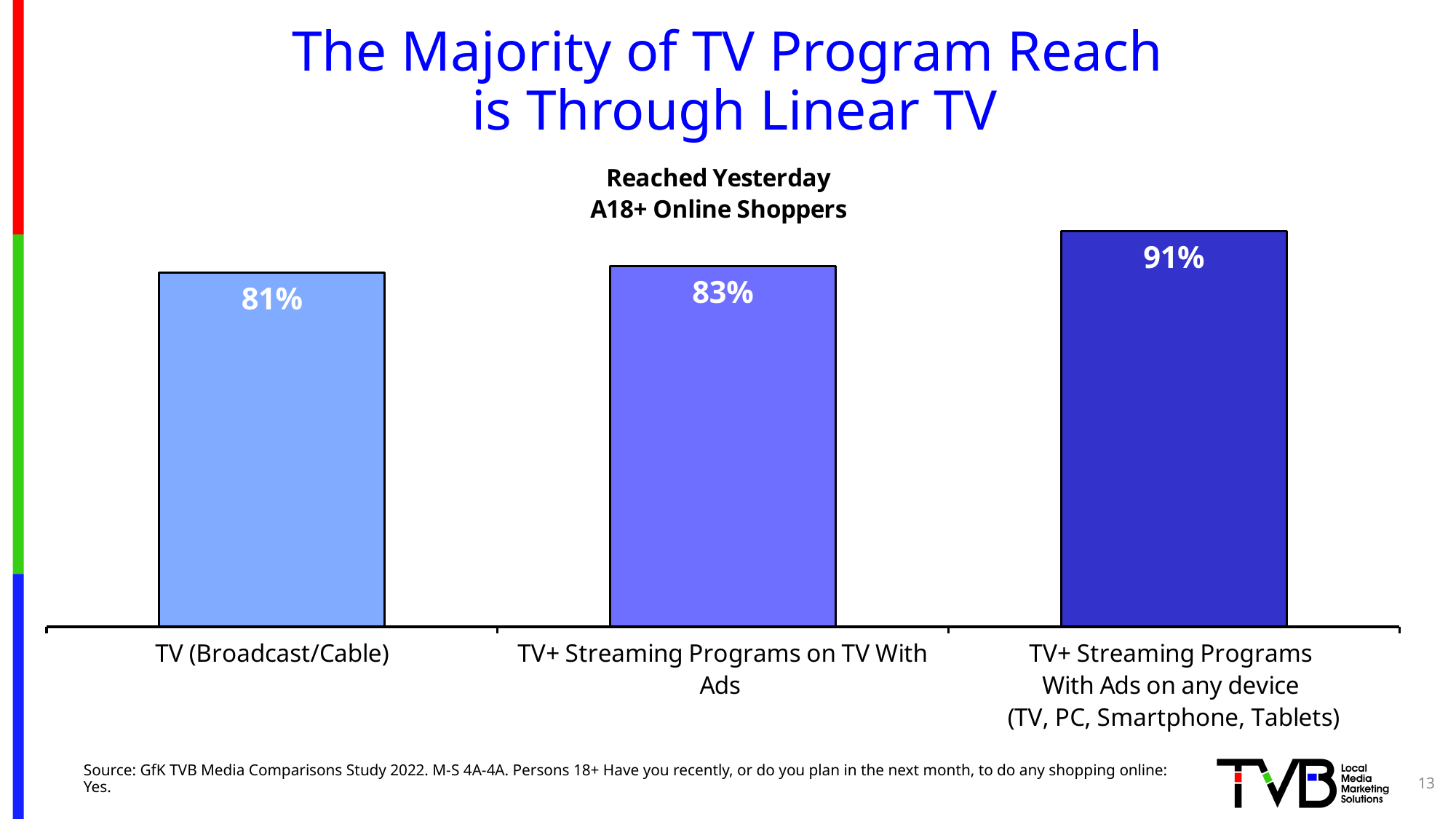
What is the value for TV+ Streaming Programs With Ads on any device (TV, PC, Smartphone, Tablets)? 91% Which category has the lowest value? TV (Broadcast/Cable) Which category has the highest value? TV+ Streaming Programs With Ads on any device (TV, PC, Smartphone, Tablets) What kind of chart is shown on the slide? Bar chart Do the values rise or fall from left to right across the categories? Rise How many categories are shown in the chart? 3 What is the difference between the value for TV+ Streaming Programs on TV With Ads and the value for TV (Broadcast/Cable)? 2% What is the difference between the value for TV+ Streaming Programs With Ads on any device and the value for TV (Broadcast/Cable)? 10% What is the title of the chart? Reached Yesterday A18+ Online Shoppers Which is larger: the value for TV (Broadcast/Cable) or the value for TV+ Streaming Programs With Ads on any device? TV+ Streaming Programs With Ads on any device What is the value for TV+ Streaming Programs on TV With Ads? 83% What is the value for TV (Broadcast/Cable)? 81%